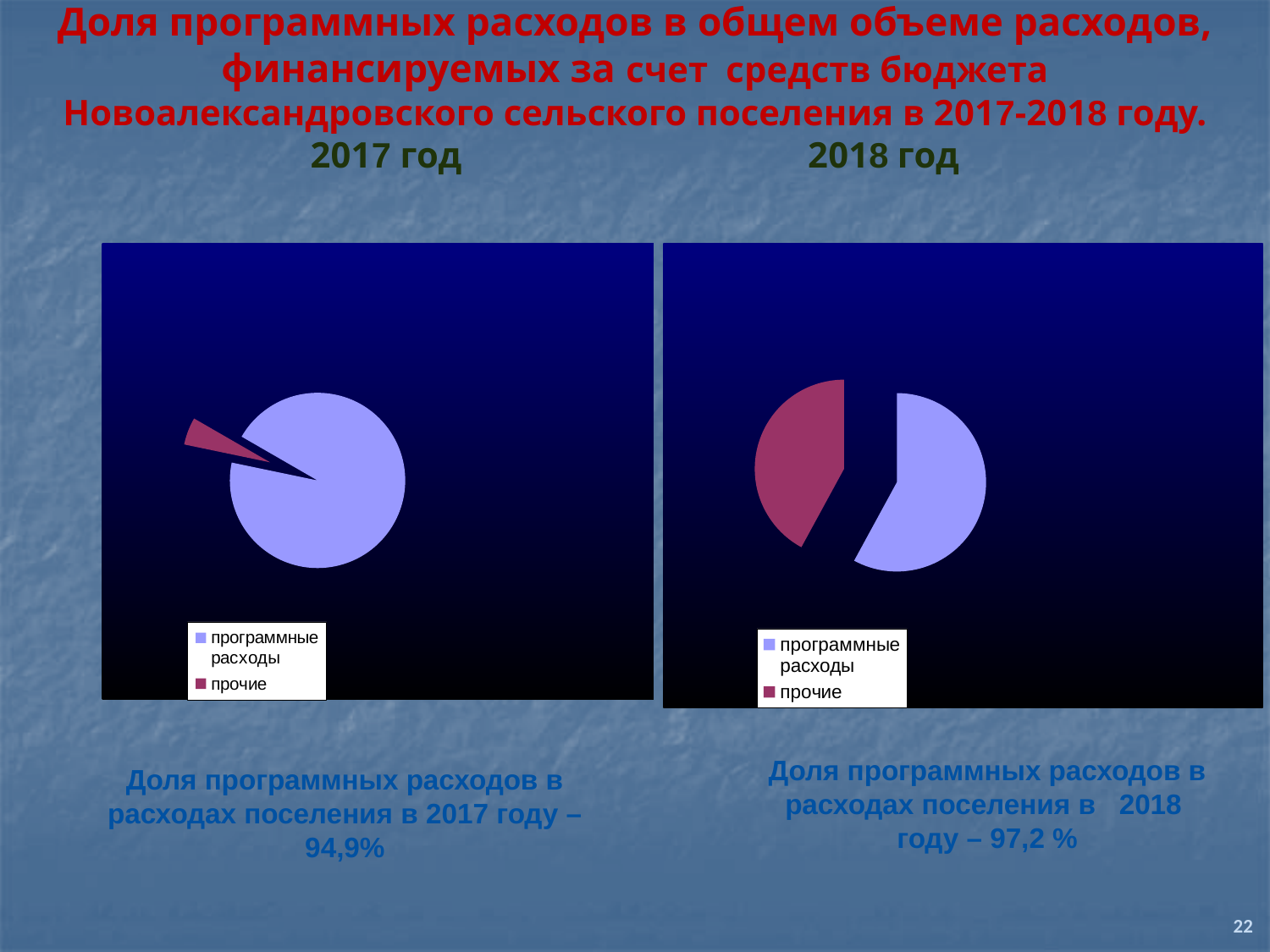
According to the caption under the 2017 год chart, what is the share of программные расходы in 2017? 94,9% In the 2017 год chart, what colour is the slice for прочие? dark red How many entries does the legend of the 2018 год chart list? 2 In the 2017 год chart, which category has the smallest slice? прочие In the 2018 год chart, which slice is larger: программные расходы or прочие? программные расходы In the 2017 год chart, which category has the largest slice? программные расходы In the 2018 год chart, which category has the largest slice? программные расходы What type of chart is shown for 2018 год? pie chart How many slices does the 2017 год pie chart have? 2 In the 2018 год chart, which category has the smallest slice? прочие What type of chart is shown for 2017 год? pie chart According to the caption under the 2018 год chart, what is the share of программные расходы in 2018? 97,2 %